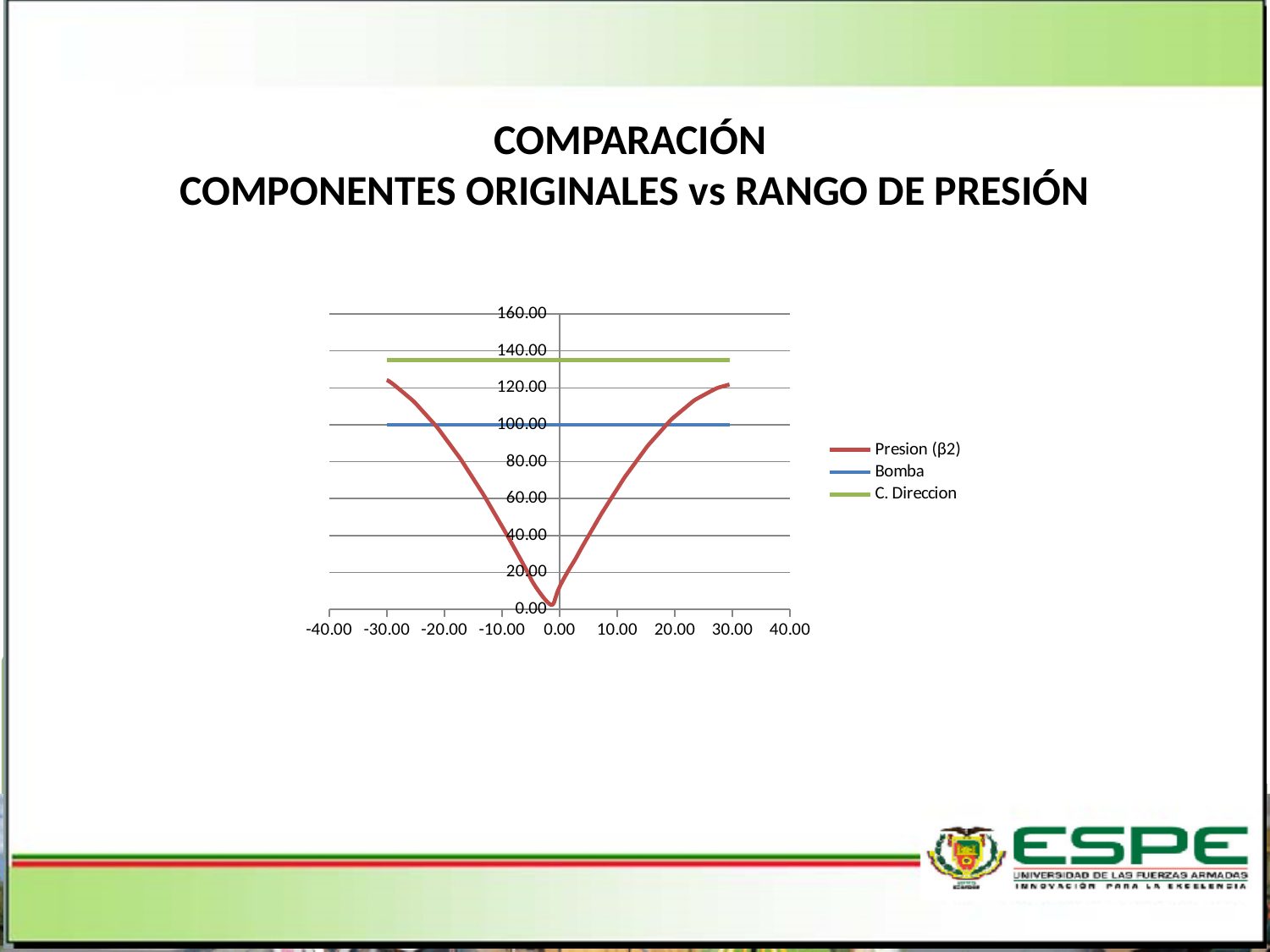
Is the value of the Presion (β2) curve at x = 0.00 greater or less than 20? less Does the Presion (β2) curve rise or fall as x goes from -30.00 to 0.00? fall Is the value of the C. Direccion line greater or less than 140? less Does the Presion (β2) curve rise or fall as x goes from 0.00 to 30.00? rise What kind of chart is shown on the slide? line chart What is the title shown above the chart? COMPARACIÓN COMPONENTES ORIGINALES vs RANGO DE PRESIÓN Is the value of the C. Direccion line greater or less than 120? greater Which series has the higher constant value, Bomba or C. Direccion? C. Direccion At what value does the Bomba line sit on the y axis? 100.00 How many series does the legend list? 3 What are the series names listed in the legend? Presion (β2), Bomba, C. Direccion